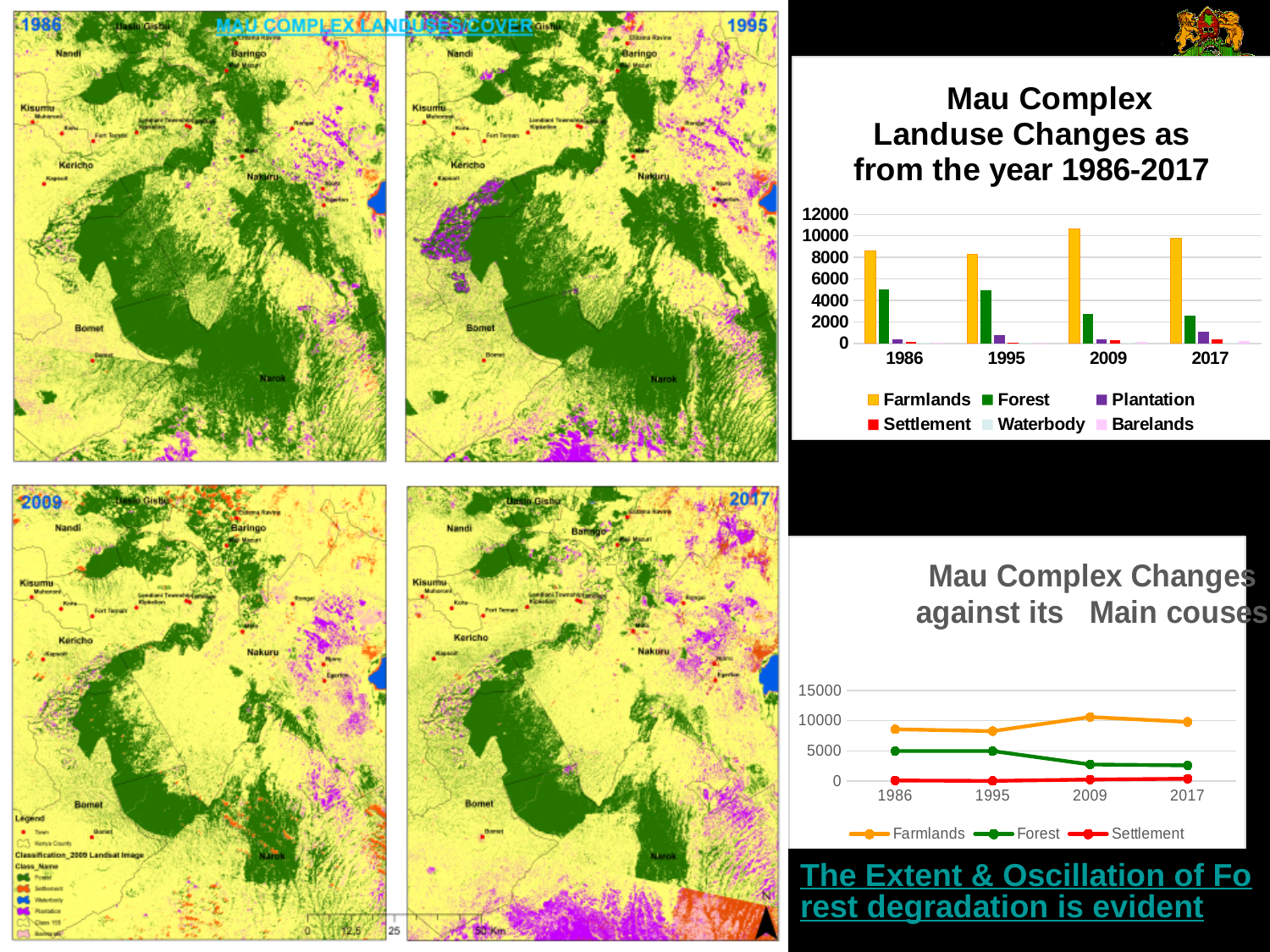
What kind of chart is the 'Mau Complex Changes against its Main couses' chart? line chart In the 'Mau Complex Landuse Changes as from the year 1986-2017' chart, is the Forest value for 2009 greater or less than 4000? less How many years are shown on the x axis of the 'Mau Complex Landuse Changes as from the year 1986-2017' chart? 4 In the 'Mau Complex Landuse Changes as from the year 1986-2017' chart, which is larger in 1986, Farmlands or Forest? Farmlands What kind of chart is the 'Mau Complex Landuse Changes as from the year 1986-2017' chart? bar chart Which series are listed in the legend of the 'Mau Complex Changes against its Main couses' chart? Farmlands, Forest, Settlement In the 'Mau Complex Changes against its Main couses' chart, does the Forest line rise or fall from 1986 to 2017? fall In the 'Mau Complex Landuse Changes as from the year 1986-2017' chart, in which year is the Farmlands bar highest? 2009 How many series does the legend of the 'Mau Complex Changes against its Main couses' chart list? 3 How many series does the legend of the 'Mau Complex Landuse Changes as from the year 1986-2017' chart list? 6 In the 'Mau Complex Landuse Changes as from the year 1986-2017' chart, is the Forest value for 1986 greater or less than 6000? less In the 'Mau Complex Landuse Changes as from the year 1986-2017' chart, is the Farmlands value for 2009 greater or less than 10000? greater